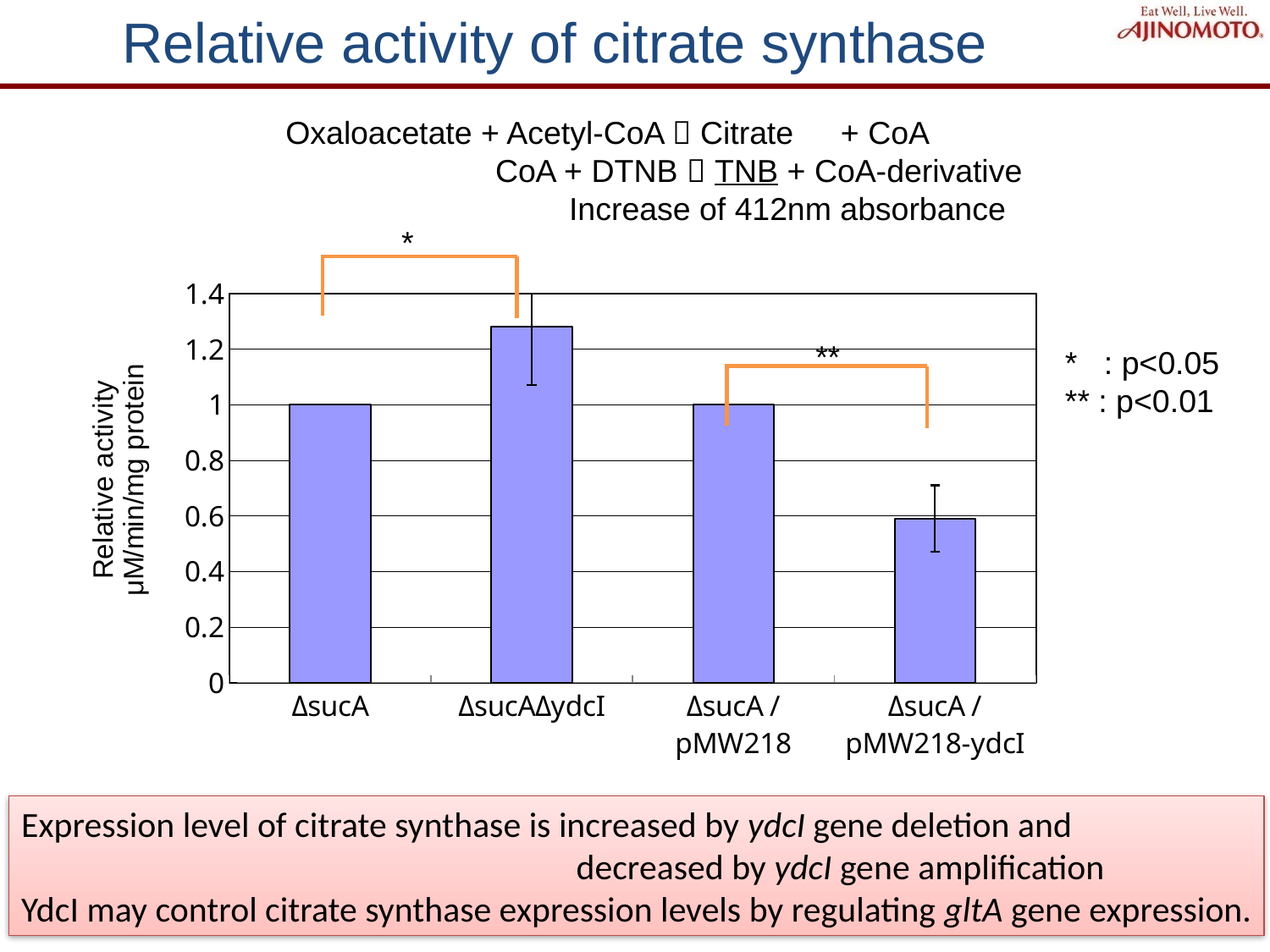
Which is larger, the value for ΔsucA / pMW218 or the value for ΔsucA / pMW218-ydcI? ΔsucA / pMW218 What is the relative activity value for ΔsucA? 1 Is the value for ΔsucA / pMW218-ydcI greater or less than 0.4? greater What is the label of the y axis of the chart? Relative activity μM/min/mg protein Is the value for ΔsucA / pMW218-ydcI greater or less than 0.8? less Which category has the lowest relative activity? ΔsucA / pMW218-ydcI How many categories (bars) are plotted in the chart? 4 Which category has the highest relative activity? ΔsucAΔydcI Which is larger, the value for ΔsucAΔydcI or the value for ΔsucA? ΔsucAΔydcI What type of chart is shown on the slide? bar chart Is the value for ΔsucAΔydcI greater or less than 1.2? greater What is the relative activity value for ΔsucA / pMW218? 1